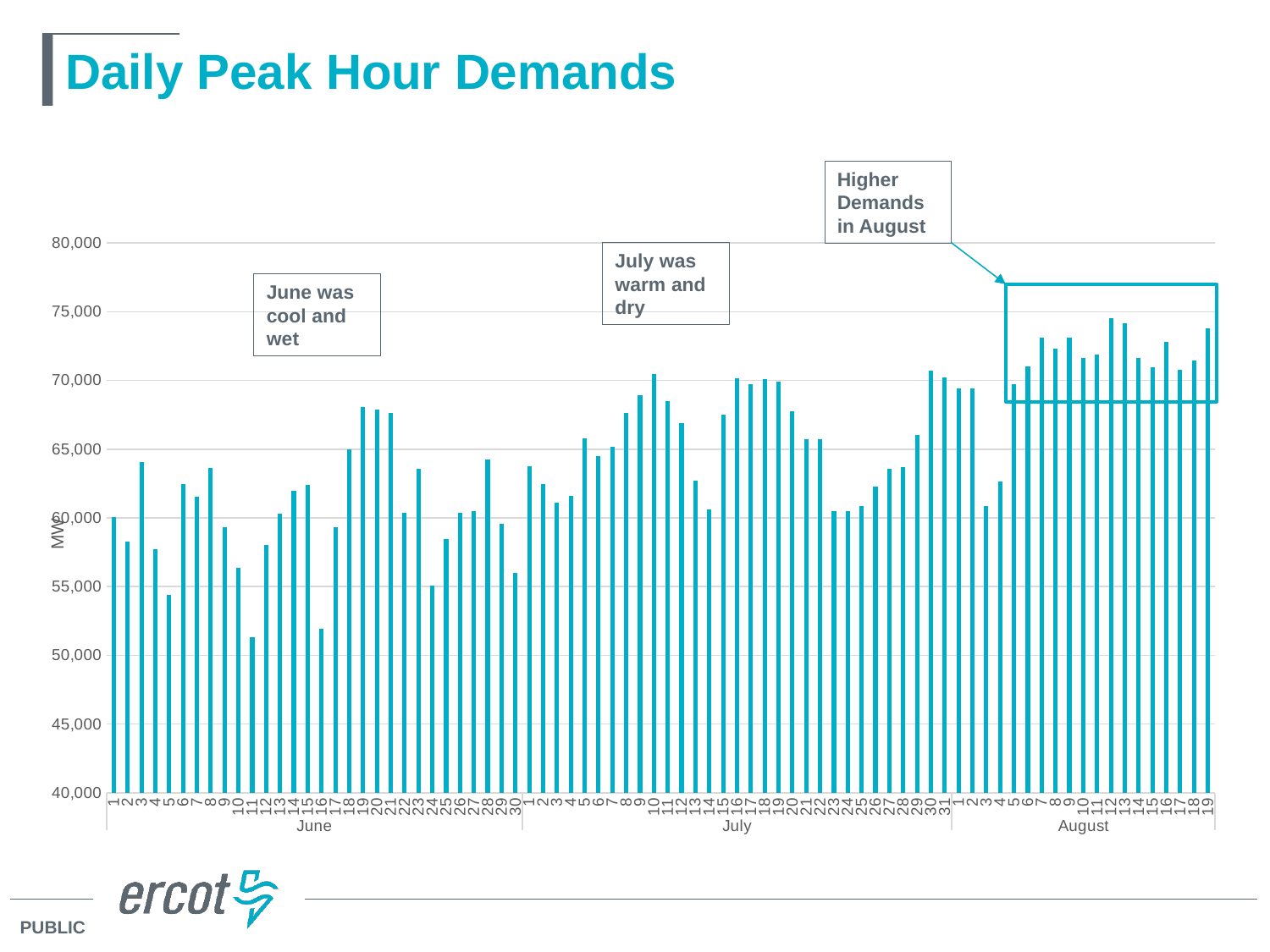
How many months are labelled along the x axis? 3 What unit is shown on the vertical axis label? MW How many daily bars are plotted for August? 19 Is the value for June 19 greater or less than 65,000? greater Is the value for July 16 greater or less than 65,000? greater Is the value for June 11 greater or less than 55,000? less Are the daily peak demands in August generally higher or lower than those in June? higher What kind of chart is shown on the slide? bar chart What is the title of the chart? Daily Peak Hour Demands Which is larger, the value for June 3 or the value for June 5? June 3 Which is larger, the value for June 11 or the value for August 12? August 12